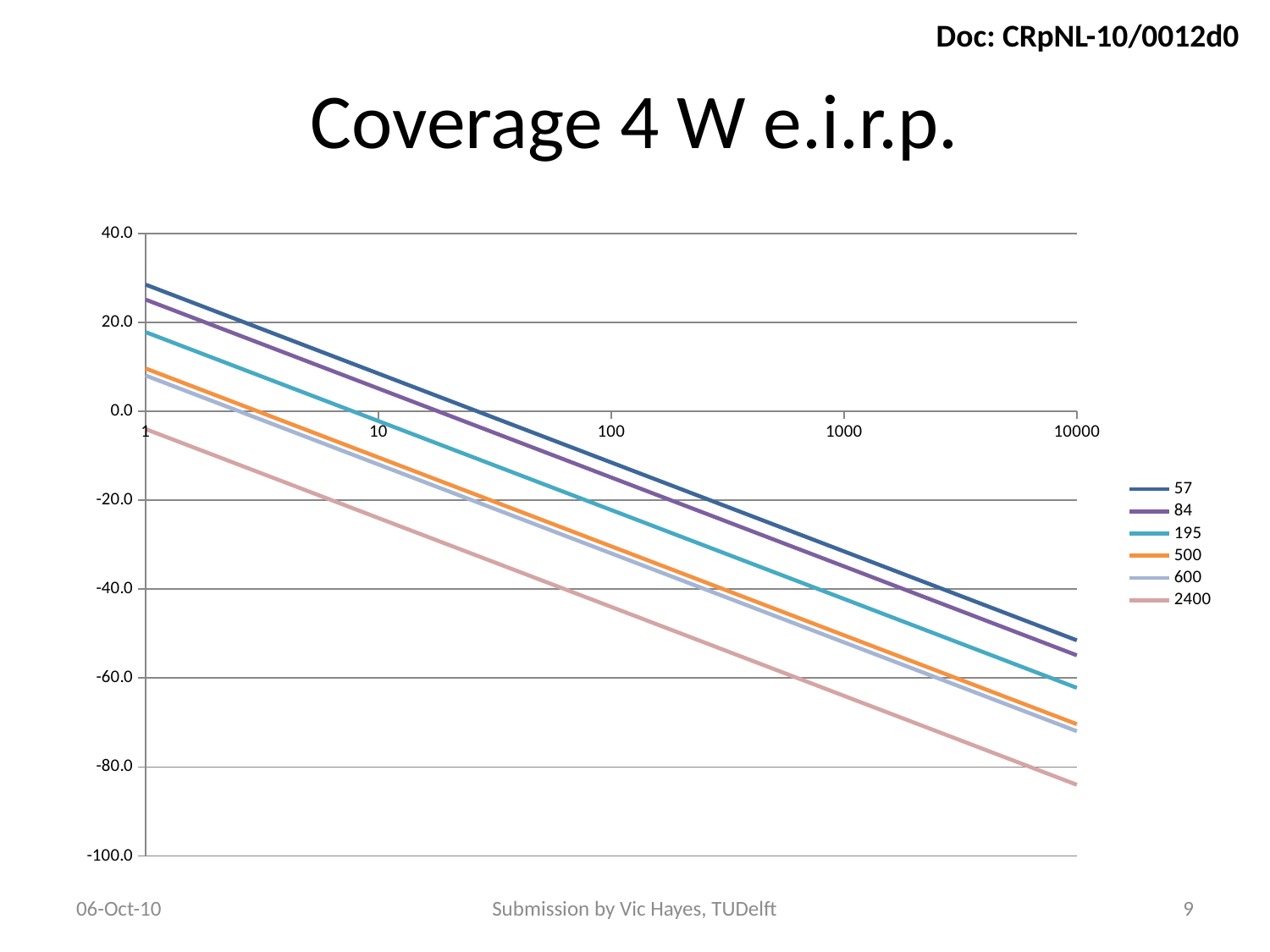
What is the title of the chart? Coverage 4 W e.i.r.p. Which series has the lowest value at x = 10000? 2400 What kind of chart is shown on the slide? line chart Which series has the highest value at x = 1? 57 Is the value of the 2400 series at x = 10000 greater or less than -80.0? less Is the value of the 2400 series at x = 1 greater or less than 0.0? less Do the values of the 2400 series rise or fall as the x axis increases? fall How many series does the legend list? 6 Which series is listed last in the legend? 2400 Is the value of the 57 series at x = 1 greater or less than 20.0? greater Do the values of the 57 series rise or fall as the x axis increases? fall At x = 10000, which series has the larger value, 57 or 2400? 57